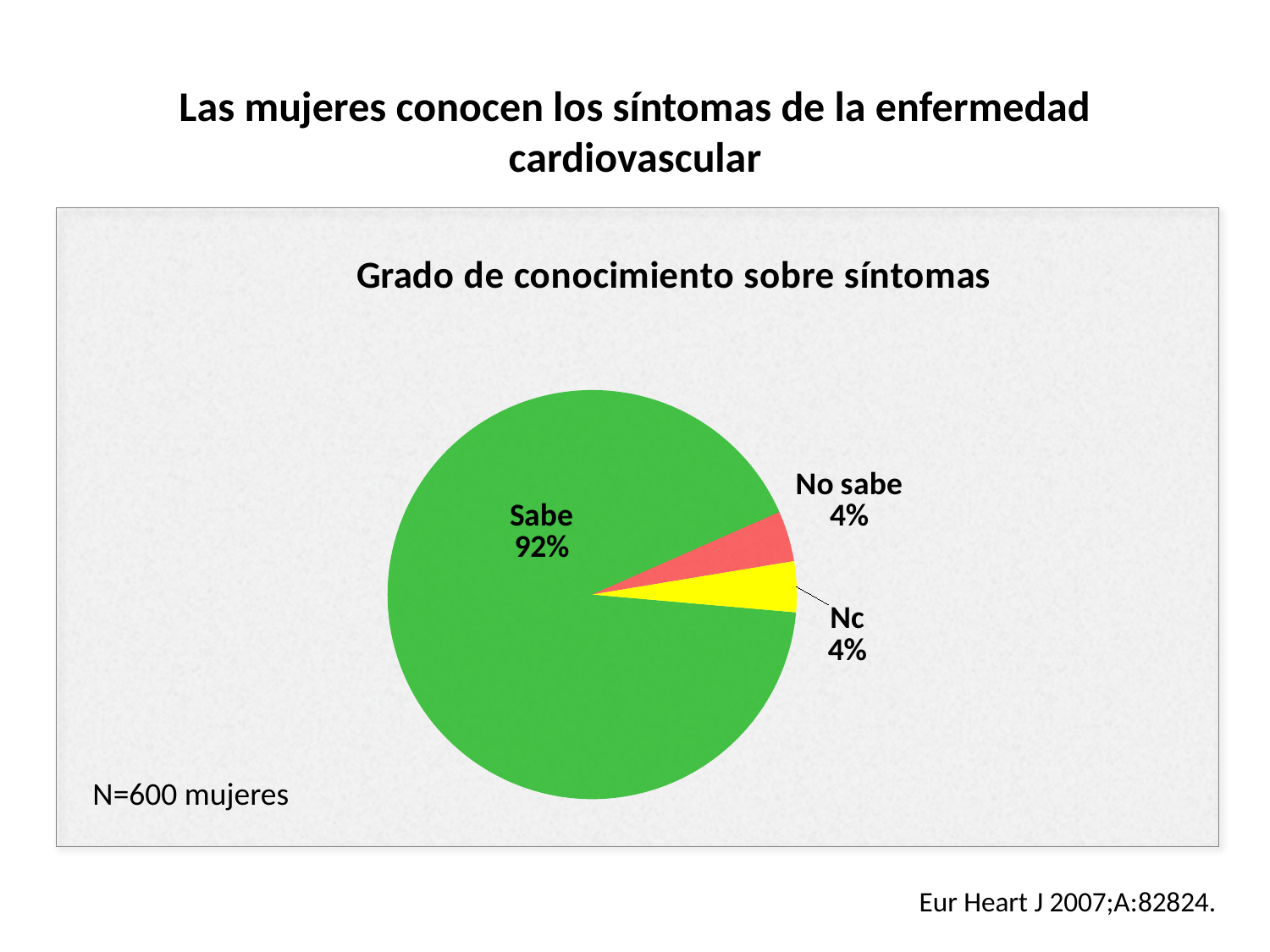
What percentage of the pie is labelled "No sabe"? 4% How many slices does the pie chart have? 3 Which slice of the pie is the largest? Sabe How many women (N) does the chart note say were surveyed? 600 What kind of chart is shown on the slide? pie chart What percentage of the pie is labelled "Nc"? 4% What is the combined share of the "No sabe" and "Nc" slices? 8% What colour is the "Sabe" slice? green What is the difference in percentage points between the "Sabe" slice and the "No sabe" slice? 88 Which is larger, the "Sabe" slice or the "Nc" slice? Sabe What is the chart's title? Grado de conocimiento sobre síntomas What percentage of the pie is labelled "Sabe"? 92%